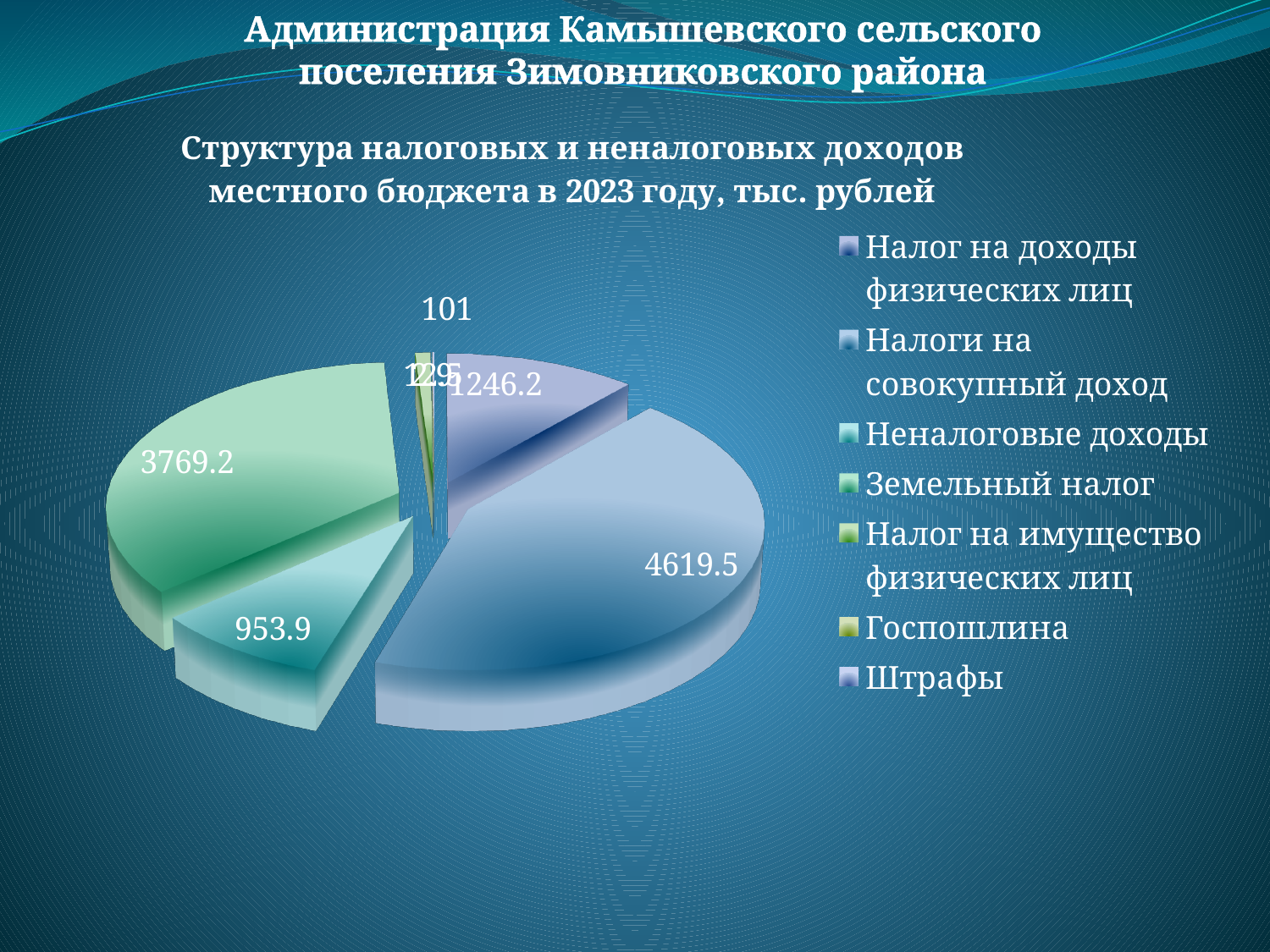
What is the largest value labelled on the pie chart? 4619.5 What type of chart is shown on the slide? Pie chart What is the difference between the values for Земельный налог and Неналоговые доходы? 2815.3 In what units are the values on the pie chart given, according to the chart title? тыс. рублей What is the difference between the two largest labelled values on the pie chart, 4619.5 and 3769.2? 850.3 What is the value labelled on the slice for Налог на доходы физических лиц? 1246.2 How many categories does the legend of the pie chart list? 7 What is the value labelled on the slice for Земельный налог? 3769.2 Which category has the largest slice in the pie chart? Налоги на совокупный доход Which is larger: the slice for Земельный налог or the slice for Неналоговые доходы? Земельный налог Which year does the pie chart's title say the data refers to? 2023 What is the value labelled on the slice for Неналоговые доходы? 953.9